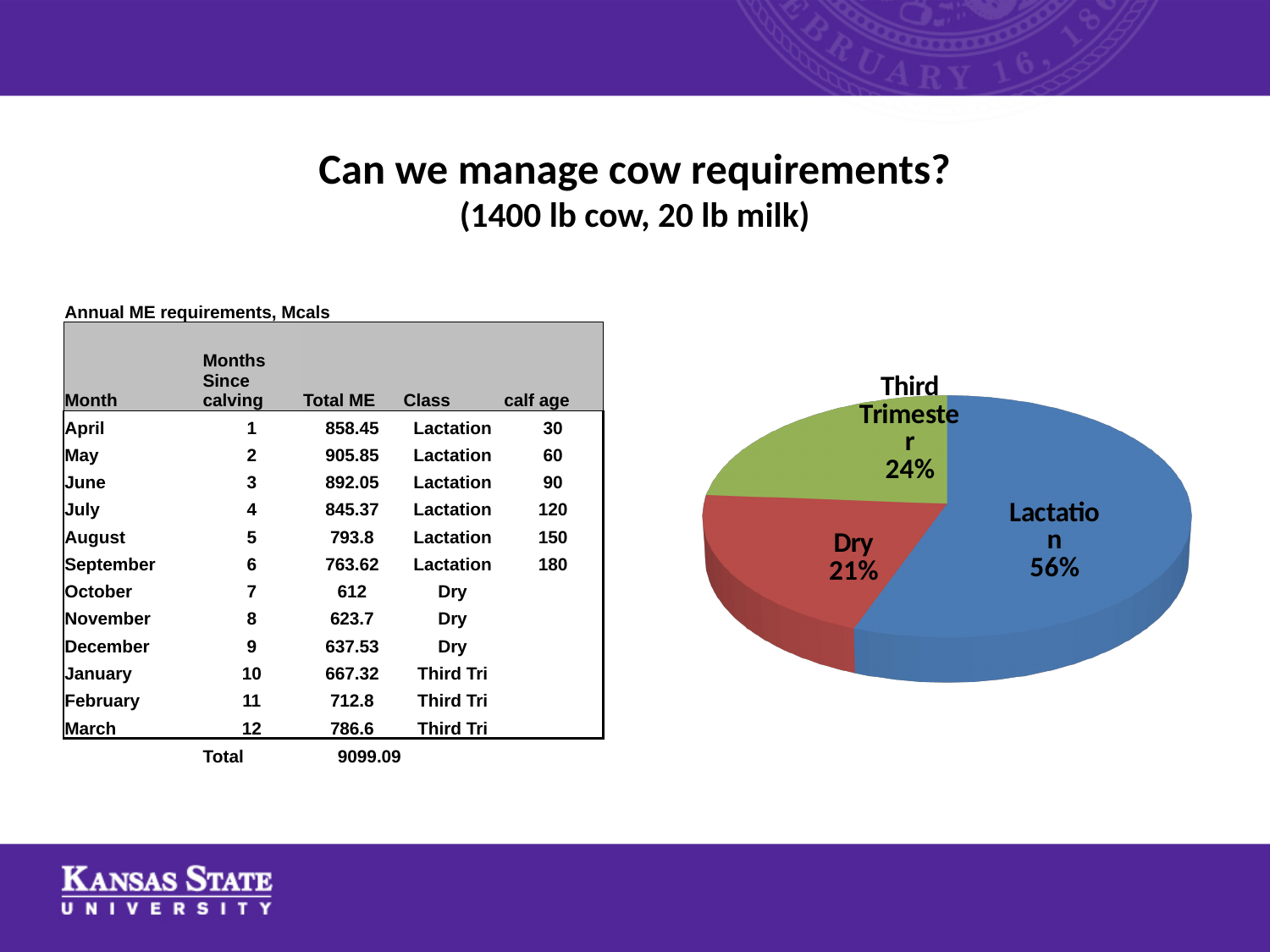
What type of chart is shown on the slide? pie chart What share of the pie chart does the Dry slice represent? 21% What colour is the Lactation slice in the pie chart? blue What share of the pie chart does the Lactation slice represent? 56% Which is larger in the pie chart, the Third Trimester slice or the Dry slice? Third Trimester What colour is the Dry slice in the pie chart? red Which slice of the pie chart is the largest? Lactation How many slices does the pie chart have? 3 By how many percentage points does the Lactation share exceed the Dry share in the pie chart? 35 Which slice of the pie chart is the smallest? Dry What share of the pie chart does the Third Trimester slice represent? 24% By how many percentage points does the Third Trimester share exceed the Dry share in the pie chart? 3